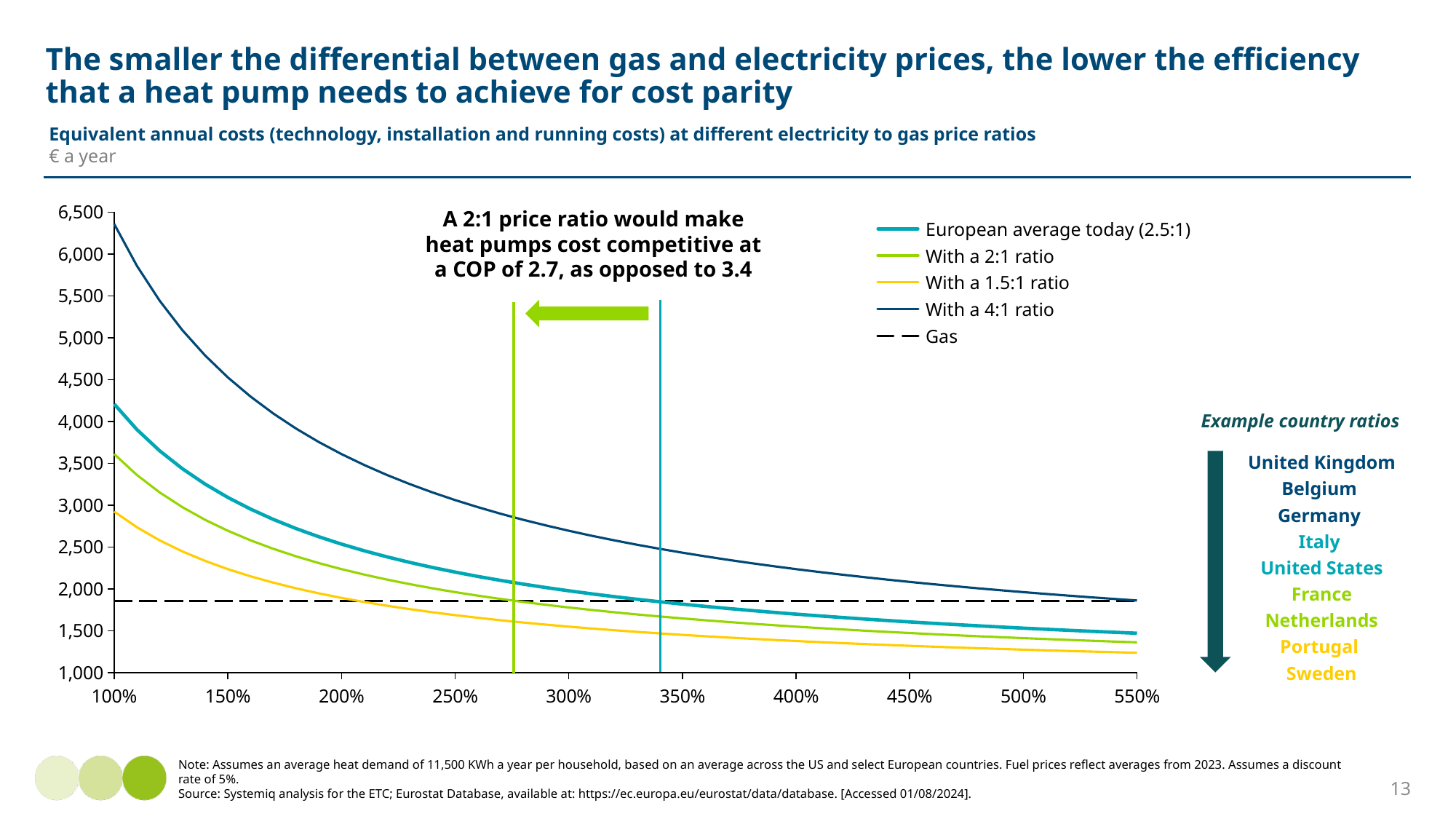
Is the value of the Gas line greater or less than 2,000? less Is the value for 'With a 4:1 ratio' at 100% greater or less than 6,000? greater Which series has the highest values across the whole chart? With a 4:1 ratio Is the value for 'European average today (2.5:1)' at 100% greater or less than 4,000? greater Which solid-line series has the lowest values across the whole chart? With a 1.5:1 ratio How many tick labels are shown on the x axis? 10 Which series is drawn as a dashed line? Gas At 100%, which is larger: the value for 'With a 2:1 ratio' or the value for 'With a 1.5:1 ratio'? With a 2:1 ratio What kind of chart is shown on the slide? Line chart How many series does the chart legend list? 5 Do the values of the 'With a 4:1 ratio' series rise or fall as the x axis increases from 100% to 550%? Fall